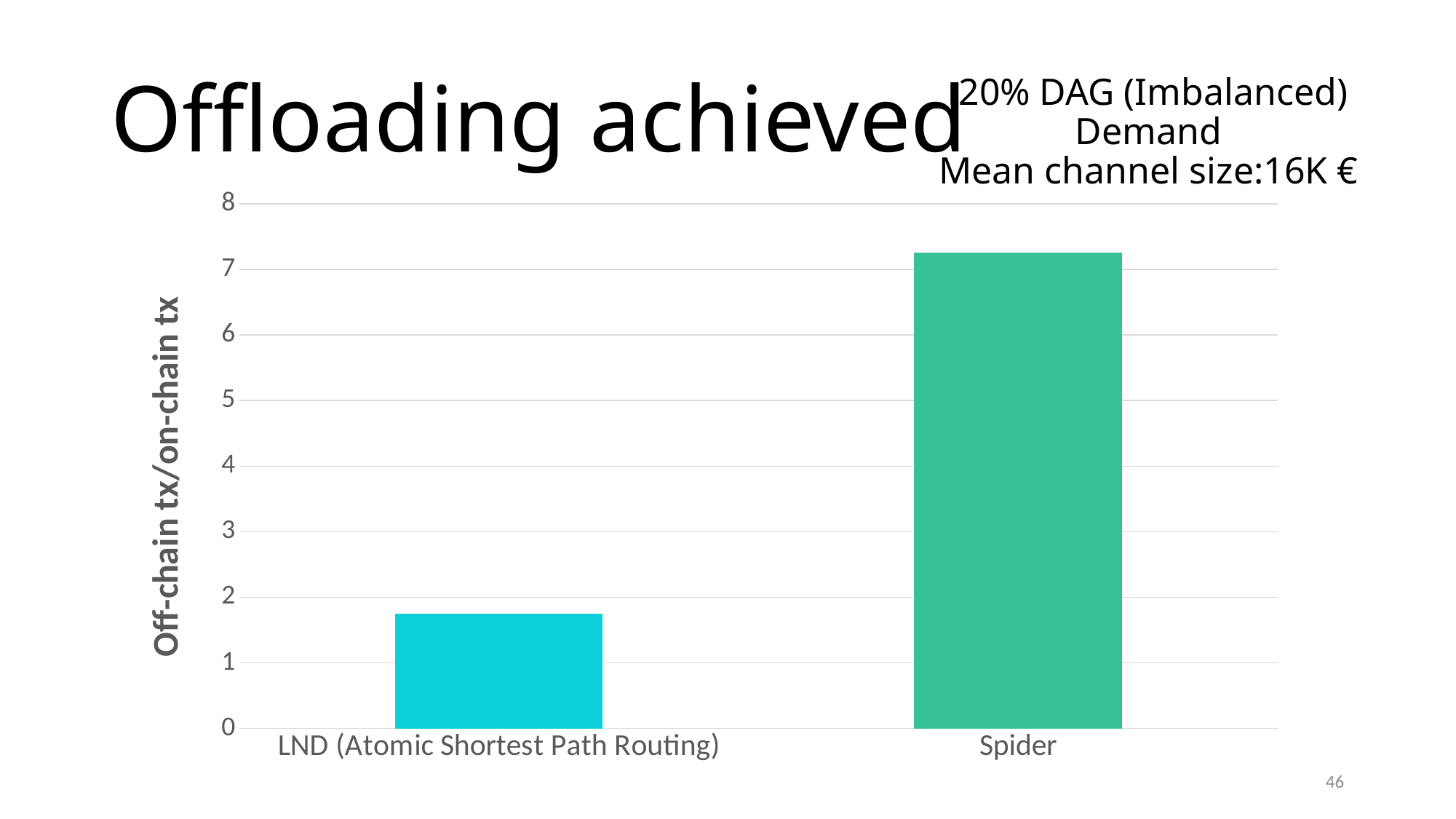
How many bars (categories) does the chart show? 2 What is the maximum value shown on the vertical axis? 8 Is the value for Spider greater or less than 7? greater What kind of chart is shown on the slide? bar chart Is the value for Spider greater or less than 8? less Is the value for LND (Atomic Shortest Path Routing) greater or less than 2? less Which category has the lowest off-chain tx/on-chain tx value? LND (Atomic Shortest Path Routing) Which is larger, the value for Spider or the value for LND (Atomic Shortest Path Routing)? Spider What is the label of the vertical axis? Off-chain tx/on-chain tx Which category has the highest off-chain tx/on-chain tx value? Spider